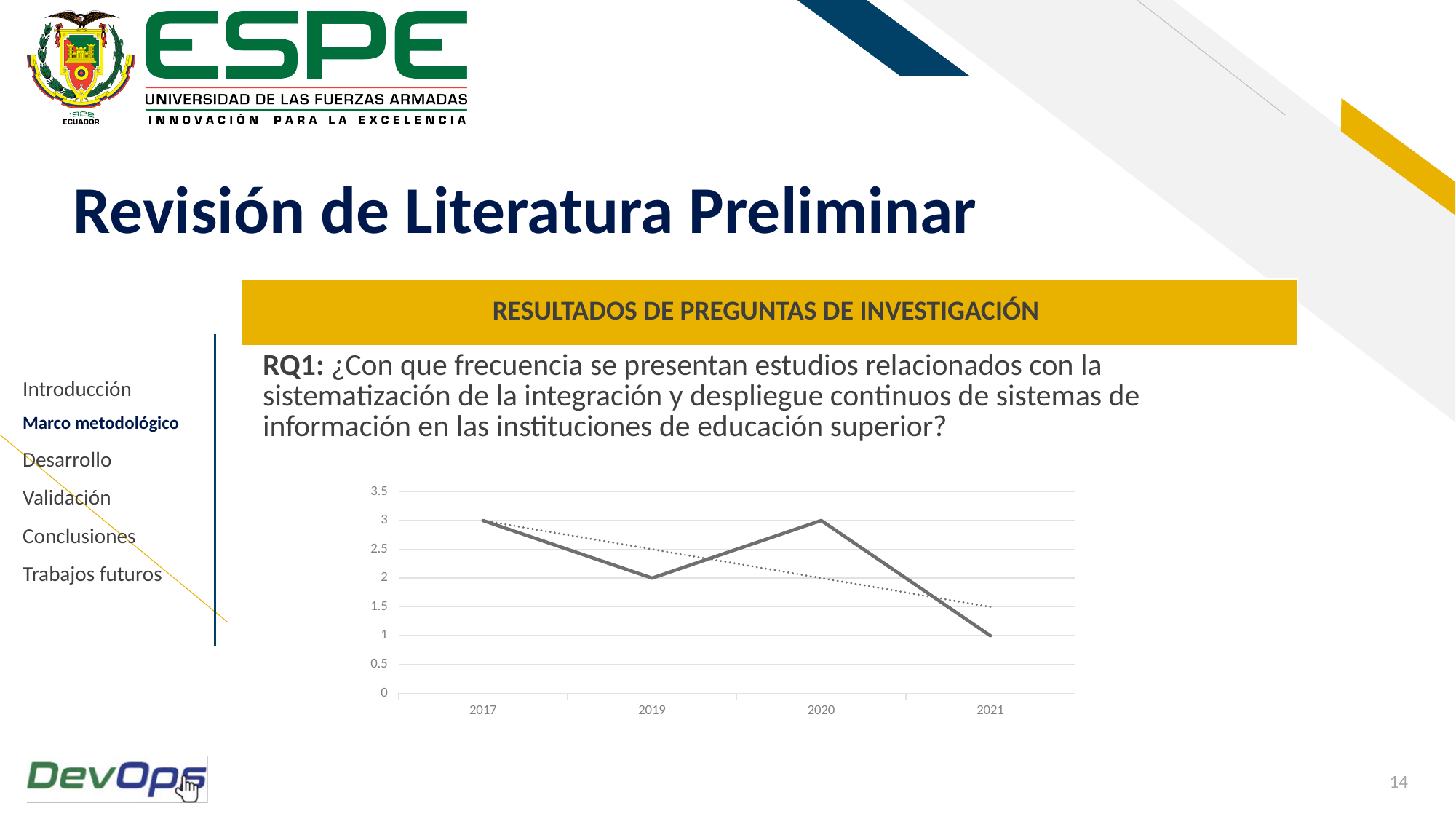
Does the dotted trend line in the chart rise or fall from 2017 to 2021? fall What is the value plotted for 2019? 2 How many years are plotted along the x axis of the chart? 4 What is the value plotted for 2017? 3 What kind of chart is shown on the slide? line chart What is the first year shown on the x axis of the chart? 2017 What is the value plotted for 2020? 3 Is the value for 2017 greater or less than 2.5? greater What is the value plotted for 2021? 1 Which year has the larger value, 2019 or 2021? 2019 Which year has the lowest value in the chart? 2021 What is the difference between the values for 2020 and 2021? 2